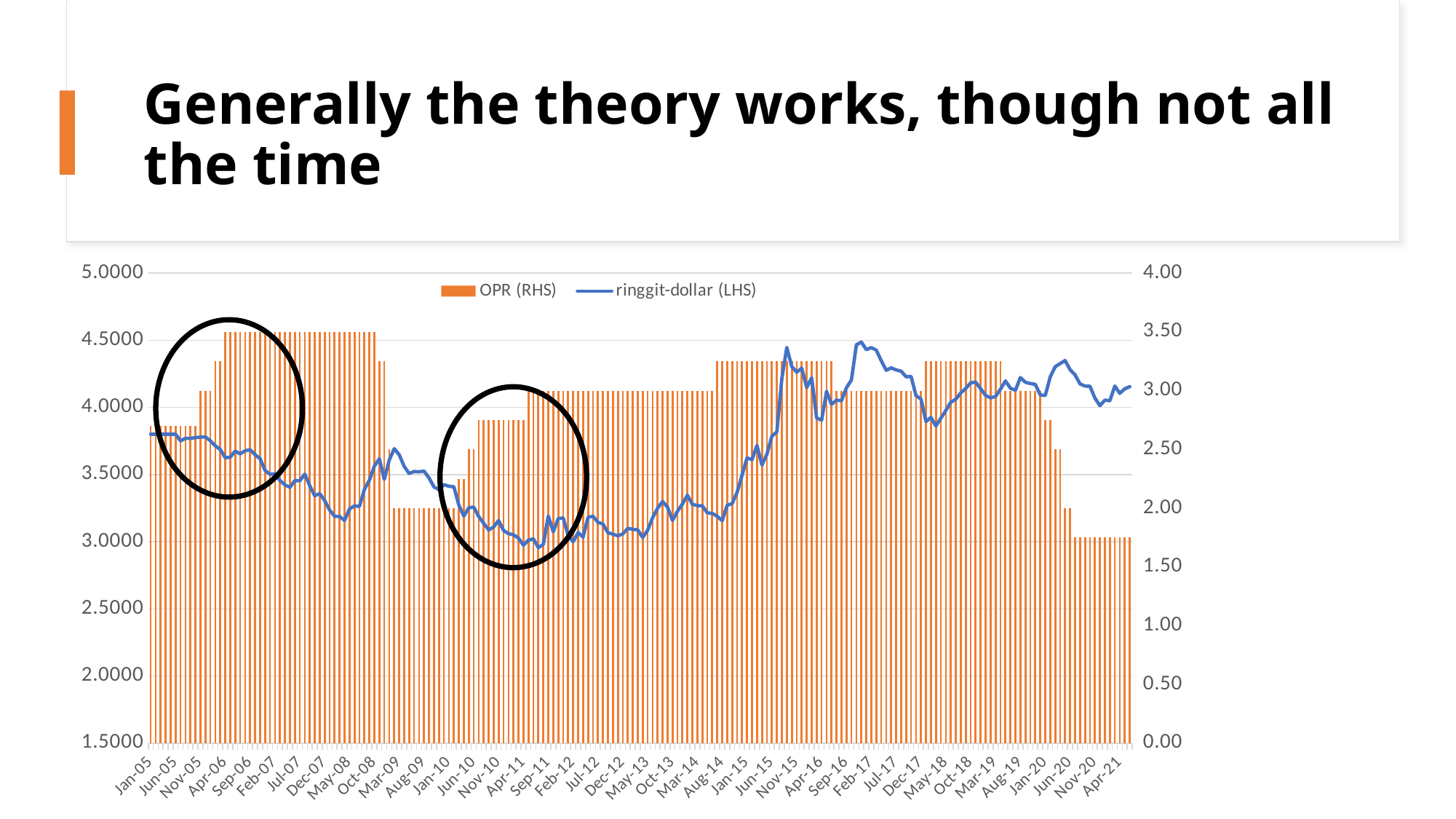
Does the ringgit-dollar (LHS) line rise or fall from Jan-05 to May-08? Fall Do the OPR (RHS) bars rise or fall from Jan-20 to Apr-21? Fall Is the ringgit-dollar (LHS) value for Jan-05 greater or less than 3.5000 on the left-hand axis? greater What kind of chart is shown on the slide? Combined bar and line chart Is the OPR (RHS) value for Jan-05 greater or less than 2.50 on the right-hand axis? greater Is the OPR (RHS) value for Jul-07 greater or less than 3.00 on the right-hand axis? greater Which series is plotted as bars? OPR (RHS) How many series does the chart's legend list? 2 Which is larger, the OPR (RHS) value in Jul-07 or in Apr-21? Jul-07 What colour is the ringgit-dollar (LHS) line? Blue